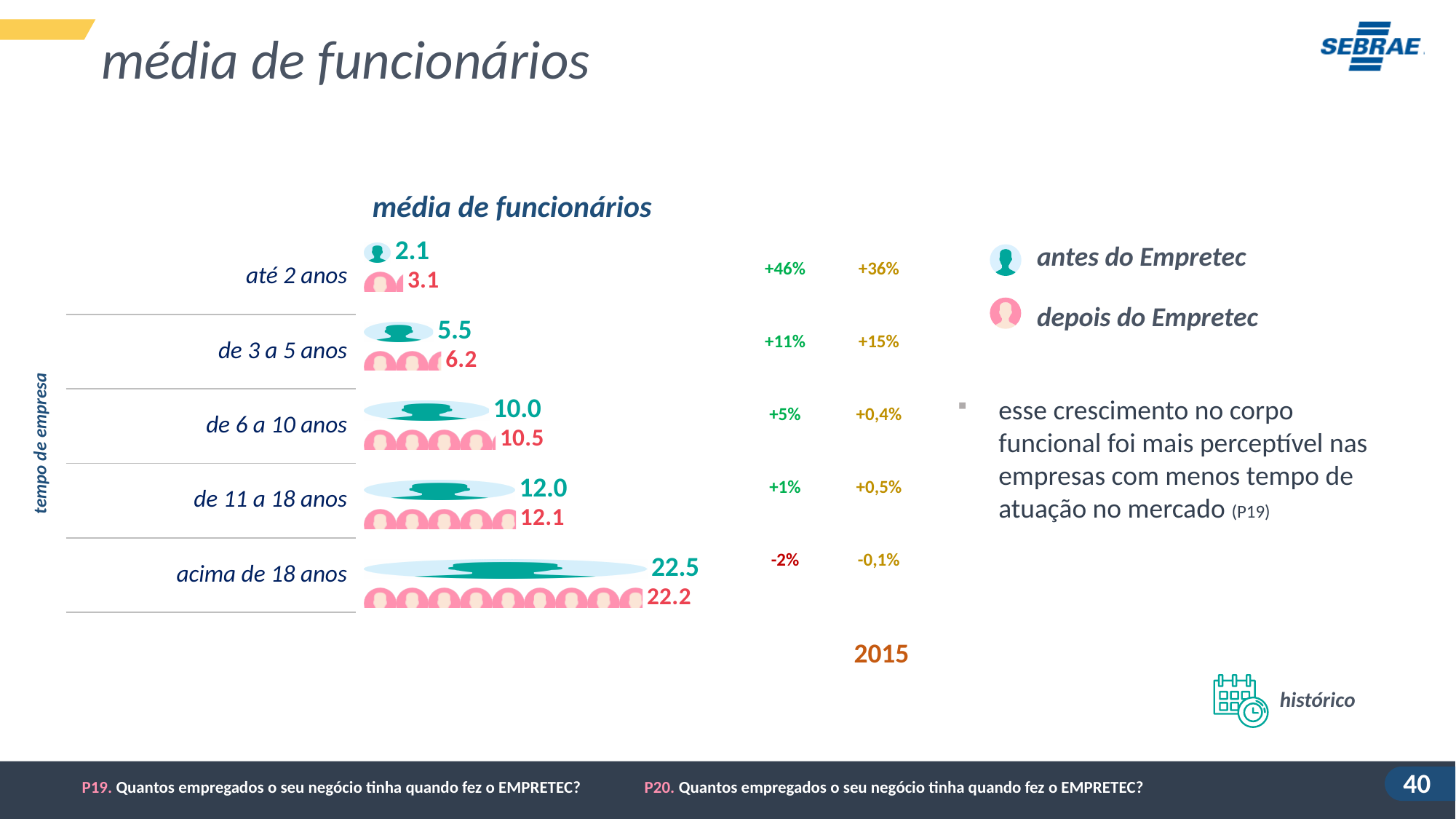
What percentage change is shown in green for companies 'até 2 anos'? +46% What is the title of the chart? média de funcionários What is the 2015 percentage change shown for companies 'acima de 18 anos'? -0,1% How many series does the legend list? 2 What is the average number of employees after Empretec for companies 'de 3 a 5 anos'? 6.2 What is the 'depois do Empretec' value for companies 'acima de 18 anos'? 22.2 What is the average number of employees before Empretec for companies 'até 2 anos'? 2.1 Which company-age category has the highest 'antes do Empretec' average number of employees? acima de 18 anos How many company-age categories are shown in the chart? 5 What is the difference between the 'depois do Empretec' and 'antes do Empretec' values for companies 'até 2 anos'? 1.0 For companies 'de 6 a 10 anos', which is larger: the value before Empretec or after Empretec? depois do Empretec (10.5) Which company-age category has the lowest 'depois do Empretec' average number of employees? até 2 anos